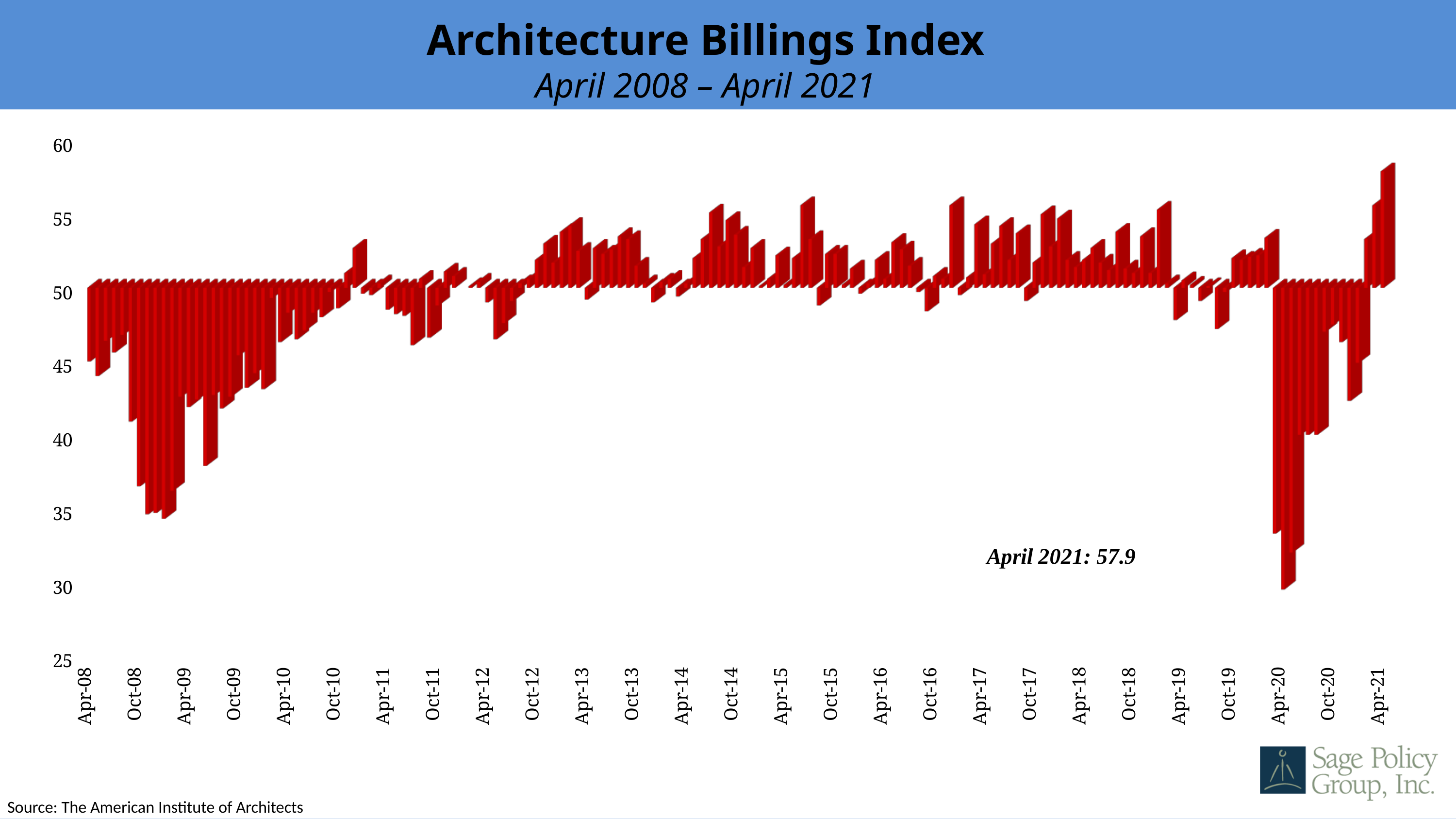
Which is larger, the value for Apr-20 or the value for Apr-21? Apr-21 Do the values rise or fall from Oct-20 to Apr-21? Rise What is the Architecture Billings Index value for April 2021? 57.9 Is the value for Apr-08 greater or less than 50? less Which month has the lowest Architecture Billings Index value on the chart? Apr-20 What is the source of the data shown on the chart? The American Institute of Architects What period does the chart cover, according to the subtitle? April 2008 – April 2021 Is the value for Apr-21 greater or less than 55? greater Is the value for Apr-20 greater or less than 35? less What kind of chart is shown on the slide? Bar chart Which month has the highest Architecture Billings Index value on the chart? Apr-21